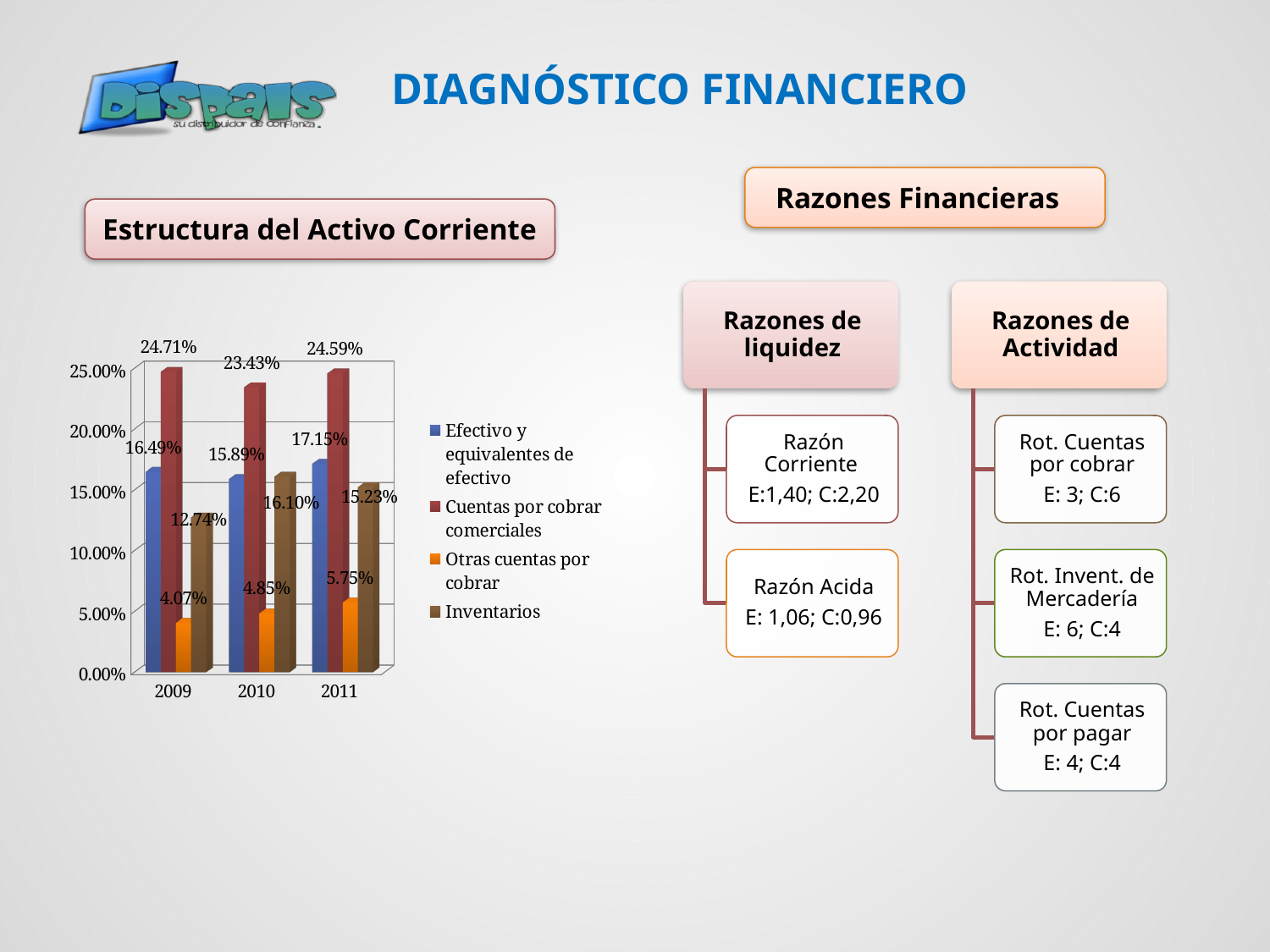
Which series has the highest value in 2010? Cuentas por cobrar comerciales How many years are shown on the x axis of the chart? 3 What kind of chart is shown on the slide? Bar chart Do the values for Otras cuentas por cobrar rise or fall from 2009 to 2011? Rise What is the value for Cuentas por cobrar comerciales in 2009? 24.71% How many series does the chart legend list? 4 What is the difference between Cuentas por cobrar comerciales and Efectivo y equivalentes de efectivo in 2009? 8.22% What is the value for Inventarios in 2010? 16.10% Which series has the lowest value in 2009? Otras cuentas por cobrar What is the value for Otras cuentas por cobrar in 2011? 5.75% Which is larger in 2010: Efectivo y equivalentes de efectivo or Inventarios? Inventarios What is the value for Efectivo y equivalentes de efectivo in 2011? 17.15%